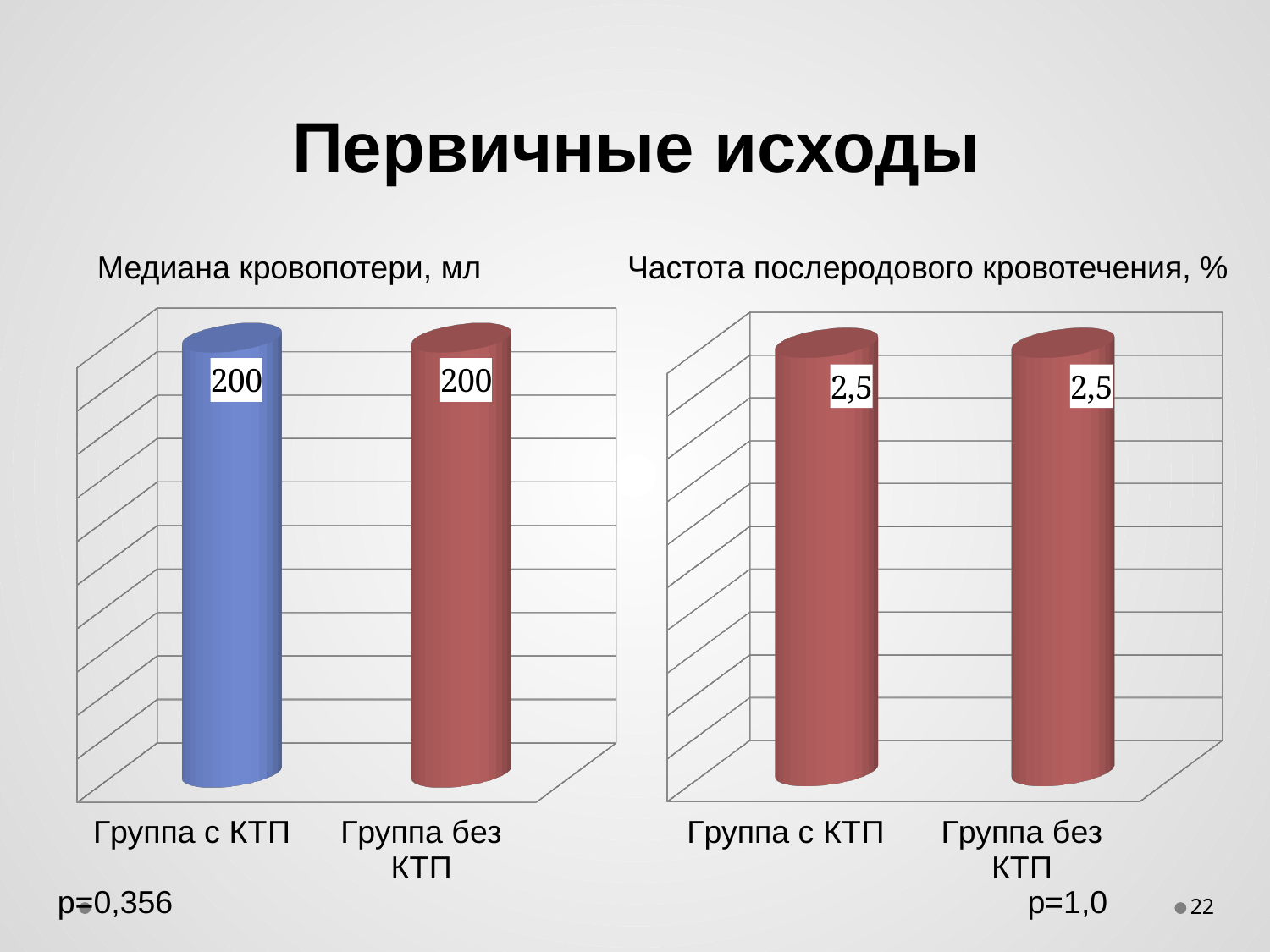
In the chart titled "Частота послеродового кровотечения, %", what is the difference between the values for "Группа с КТП" and "Группа без КТП"? 0 How many categories are shown in the chart titled "Медиана кровопотери, мл"? 2 In the chart titled "Медиана кровопотери, мл", what is the value for "Группа с КТП"? 200 In the chart titled "Медиана кровопотери, мл", what colour is the bar for "Группа с КТП"? Blue What is the title of the left chart on the slide? Медиана кровопотери, мл What kind of chart is the right chart on the slide? Bar chart In the chart titled "Частота послеродового кровотечения, %", what is the value for "Группа с КТП"? 2,5 In the chart titled "Частота послеродового кровотечения, %", what is the value for "Группа без КТП"? 2,5 In the chart titled "Медиана кровопотери, мл", what is the value for "Группа без КТП"? 200 In the chart titled "Медиана кровопотери, мл", what is the difference between the values for "Группа с КТП" and "Группа без КТП"? 0 How many categories are shown in the chart titled "Частота послеродового кровотечения, %"? 2 What kind of chart is the left chart on the slide? Bar chart